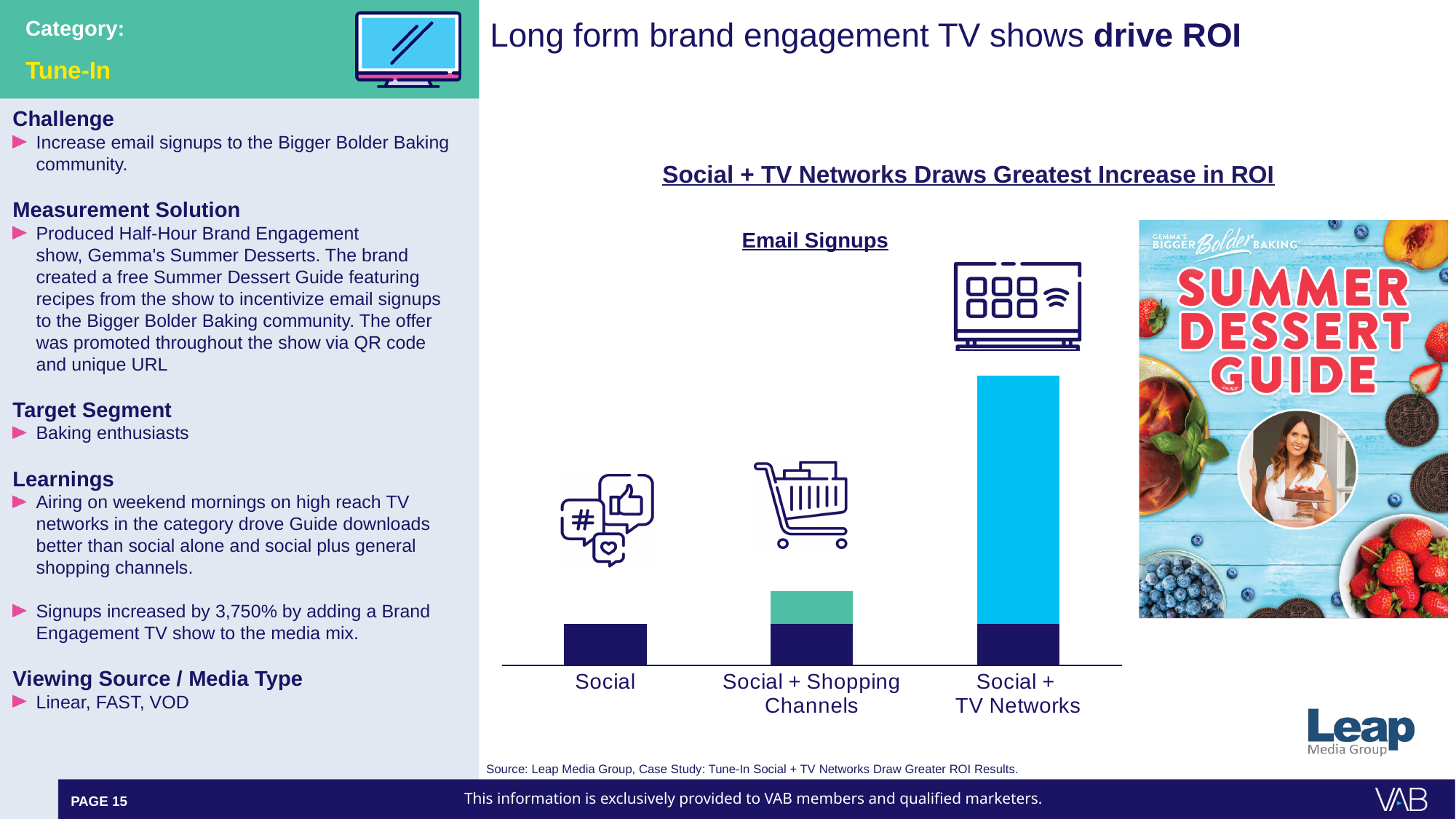
Do the bar heights in the Email Signups chart rise or fall from left to right? rise How many categories are shown on the x axis of the Email Signups chart? 3 In the Email Signups chart, which bar is taller: Social + Shopping Channels or Social + TV Networks? Social + TV Networks What kind of chart is shown under the heading "Email Signups"? bar chart What is the label of the middle category on the x axis of the Email Signups chart? Social + Shopping Channels What is the underlined heading directly above the bar chart? Email Signups Which category has the tallest bar in the Email Signups chart? Social + TV Networks Which category has the shortest bar in the Email Signups chart? Social In the Email Signups chart, which bar is taller: Social or Social + Shopping Channels? Social + Shopping Channels